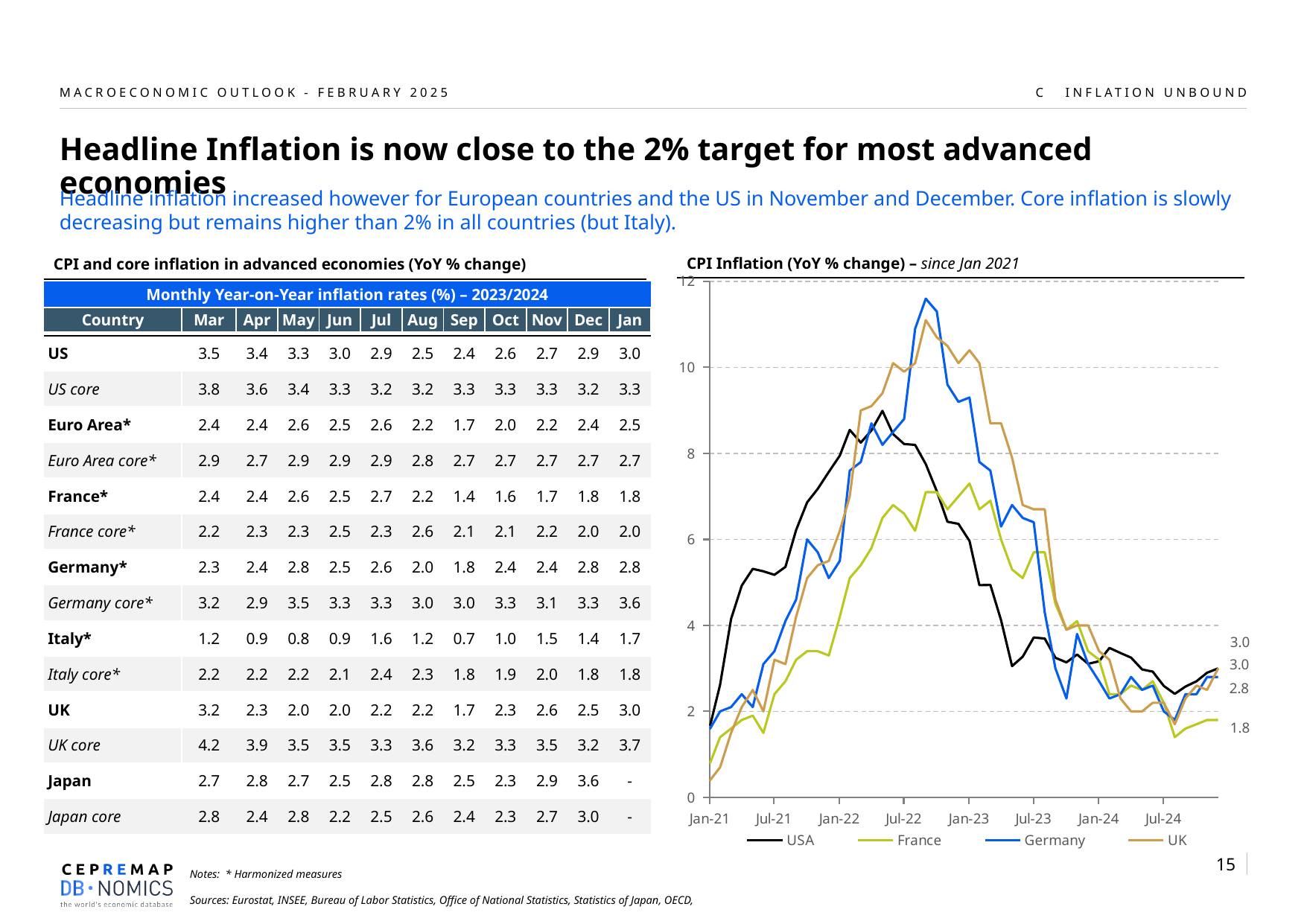
In the CPI Inflation chart, what is the latest value labelled for Germany? 2.8 In the CPI Inflation chart, what is the latest value labelled for France? 1.8 In the CPI Inflation chart, is the peak value for France greater or less than 8? less What kind of chart is the 'CPI Inflation (YoY % change) – since Jan 2021' chart? line chart Which countries are listed in the legend of the CPI Inflation chart? USA, France, Germany, UK How many series does the legend of the CPI Inflation chart list? 4 In the CPI Inflation chart, which series has the lowest value at the end of the period? France In the CPI Inflation chart, does the USA series rise or fall between Jan-23 and Jul-24? fall In the CPI Inflation chart, at the end of the period, is the value for Germany or France larger? Germany In the CPI Inflation chart, is the peak value for the USA greater or less than 10? less In the CPI Inflation chart, is the peak value for Germany greater or less than 10? greater In the CPI Inflation chart, which series reached the highest peak? Germany